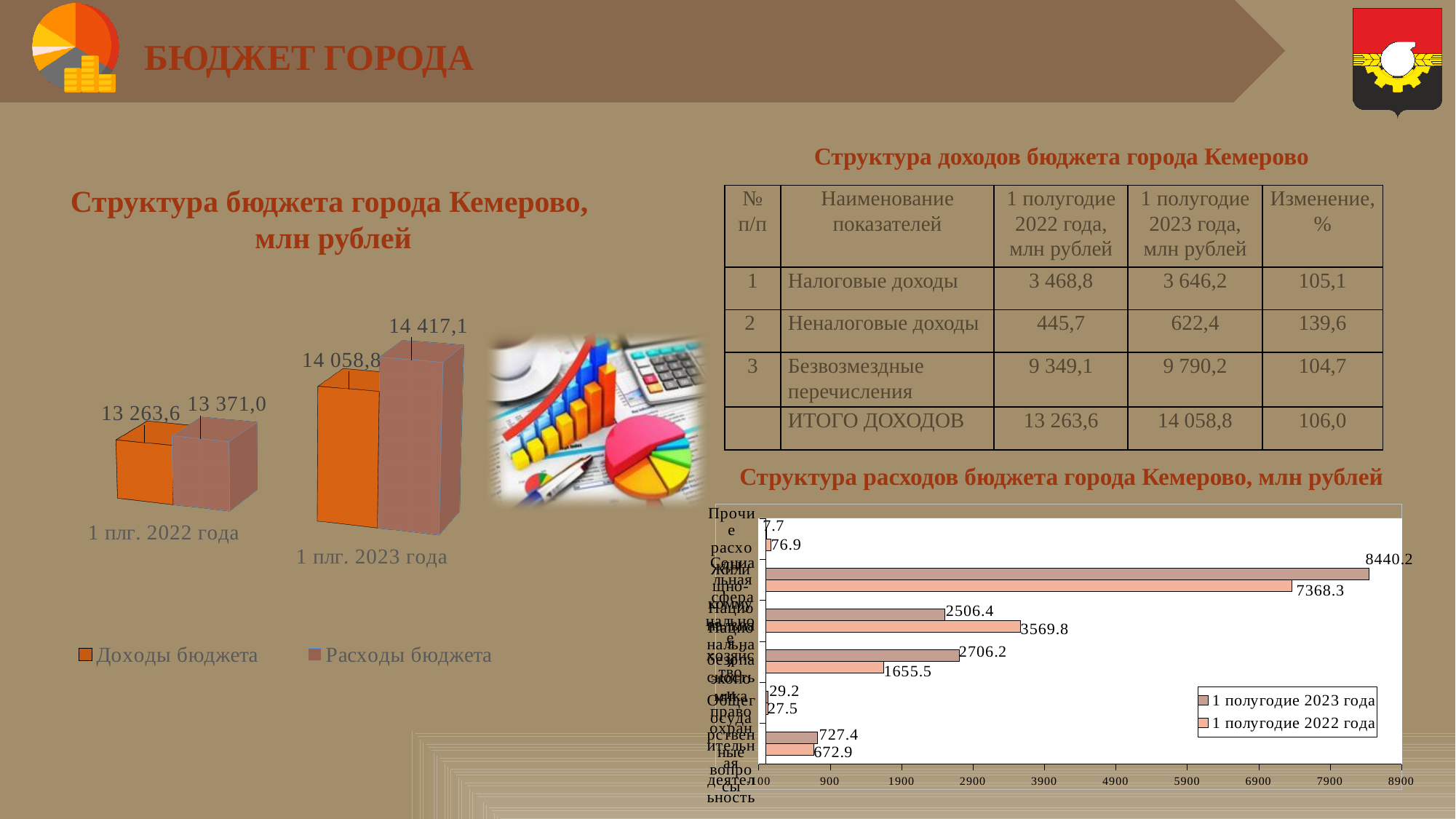
On the chart 'Структура бюджета города Кемерово, млн рублей', do the Доходы бюджета values rise or fall from 1 плг. 2022 года to 1 плг. 2023 года? rise On the chart 'Структура расходов бюджета города Кемерово, млн рублей', which two series does the legend list? 1 полугодие 2023 года and 1 полугодие 2022 года On the chart 'Структура расходов бюджета города Кемерово, млн рублей', what is the highest value shown for 1 полугодие 2022 года? 7368.3 On the chart 'Структура бюджета города Кемерово, млн рублей', what is the value of Расходы бюджета for 1 плг. 2022 года? 13 371,0 On the chart 'Структура бюджета города Кемерово, млн рублей', which is larger for 1 плг. 2023 года: Доходы бюджета or Расходы бюджета? Расходы бюджета On the chart 'Структура бюджета города Кемерово, млн рублей', how many series does the legend list? 2 On the chart 'Структура расходов бюджета города Кемерово, млн рублей', how many categories are plotted? 6 On the chart 'Структура расходов бюджета города Кемерово, млн рублей', what is the highest value shown for 1 полугодие 2023 года? 8440.2 On the chart 'Структура бюджета города Кемерово, млн рублей', what is the difference between Расходы бюджета and Доходы бюджета for 1 плг. 2023 года? 358,3 What kind of chart is 'Структура расходов бюджета города Кемерово, млн рублей'? bar chart On the chart 'Структура бюджета города Кемерово, млн рублей', what is the value of Расходы бюджета for 1 плг. 2023 года? 14 417,1 On the chart 'Структура бюджета города Кемерово, млн рублей', what is the value of Доходы бюджета for 1 плг. 2022 года? 13 263,6